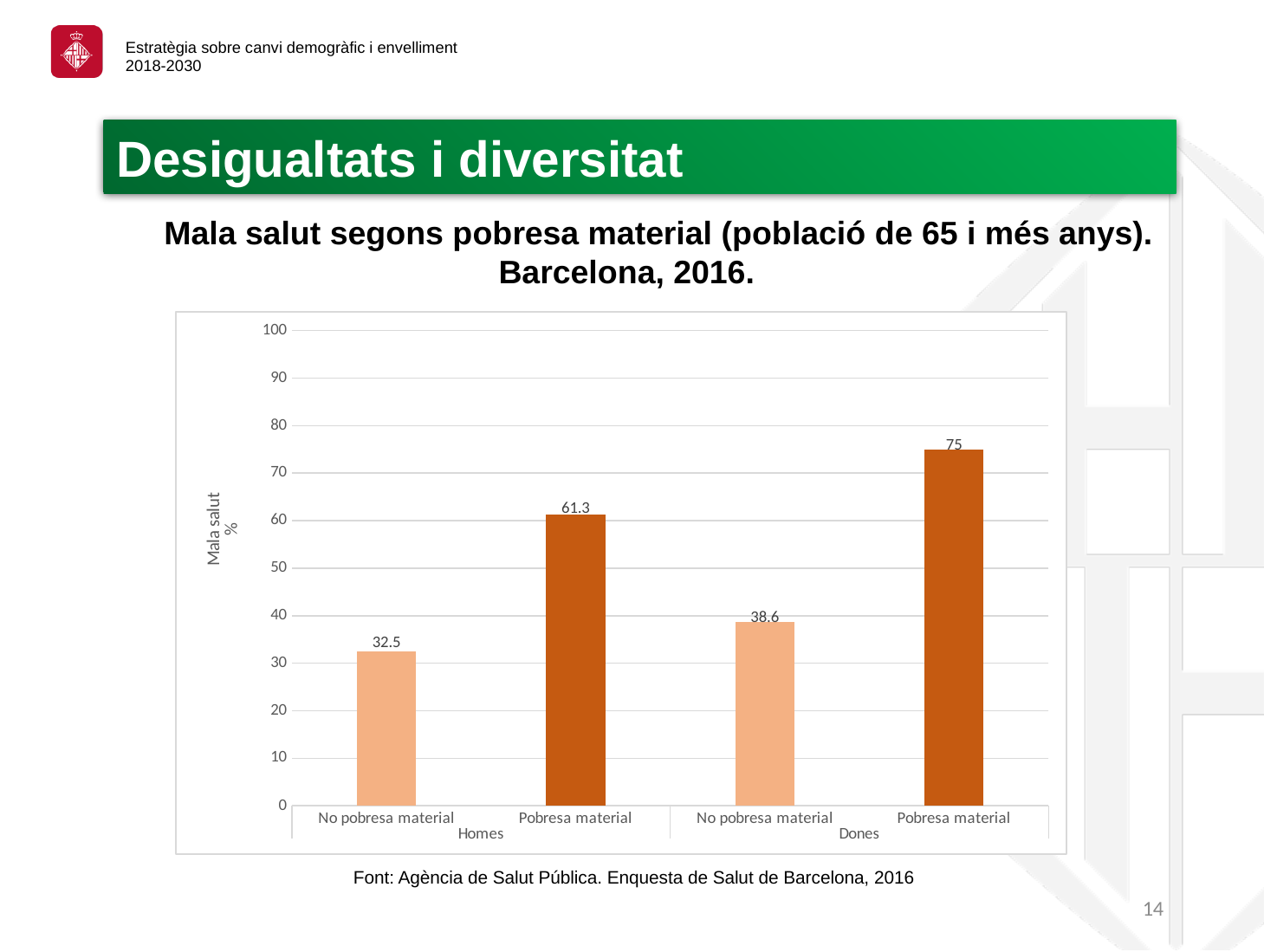
Which is larger: 'No pobresa material' for Homes or 'No pobresa material' for Dones? No pobresa material for Dones What kind of chart is shown on the slide? Bar chart How many bars are plotted in the chart? 4 What is the value for 'No pobresa material' among Dones? 38.6 What is the difference between 'Pobresa material' and 'No pobresa material' among Dones? 36.4 What is the value for 'Pobresa material' among Dones? 75 Which bar has the lowest value? No pobresa material (Homes) What is the label of the vertical axis? Mala salut % What is the difference between 'Pobresa material' and 'No pobresa material' among Homes? 28.8 What is the value for 'Pobresa material' among Homes? 61.3 What is the value for 'No pobresa material' among Homes? 32.5 Which bar has the highest value? Pobresa material (Dones)